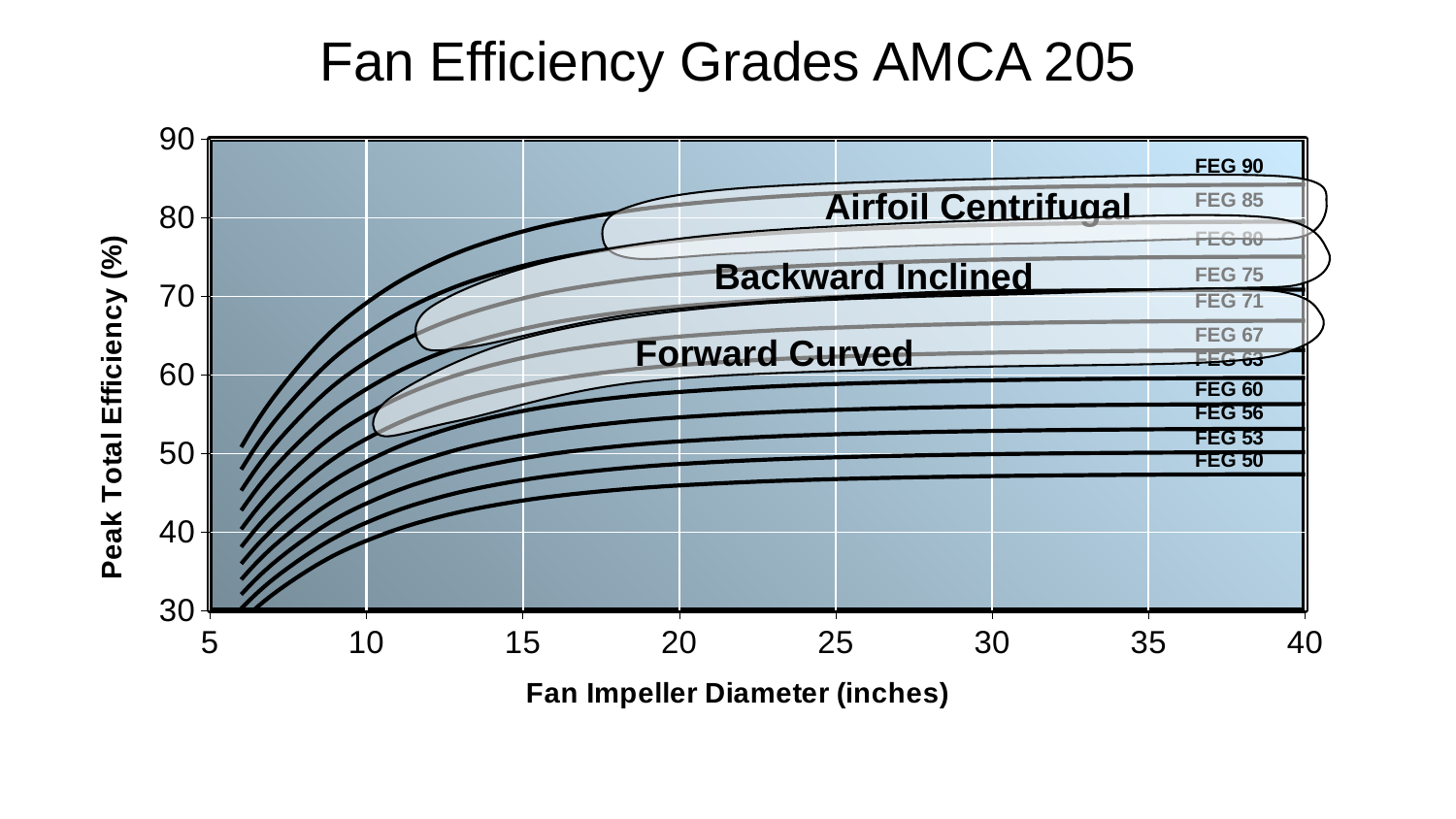
What is the label of the x axis? Fan Impeller Diameter (inches) Do the FEG curves rise or fall as fan impeller diameter increases? Rise How many FEG curves are labelled on the chart? 11 Is the value of the FEG 60 curve at 10 inches greater or less than 60? less What is the title of the chart? Fan Efficiency Grades AMCA 205 Is the value of the FEG 50 curve at 40 inches greater or less than 50? less What kind of chart is shown on the slide? Line chart Which FEG curve is the lowest on the chart? FEG 50 Which FEG curve is the highest on the chart? FEG 90 Which curve is higher at 40 inches, FEG 85 or FEG 60? FEG 85 Is the value of the FEG 90 curve at 40 inches greater or less than 80? greater